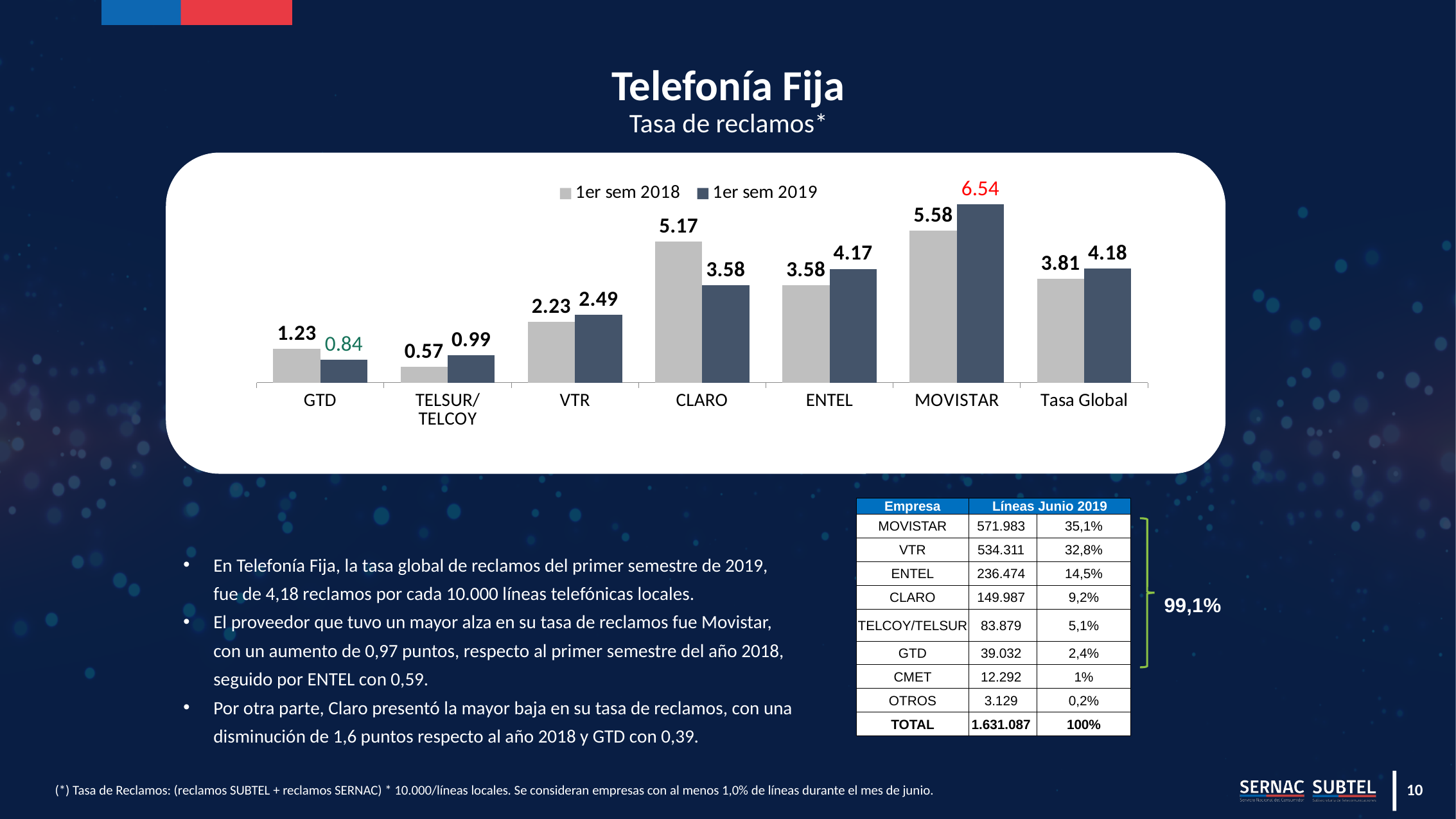
What is the difference between the 1er sem 2019 and 1er sem 2018 values for MOVISTAR? 0.96 Which category has the highest value in the 1er sem 2019 series? MOVISTAR What kind of chart is shown on the slide? Bar chart Which is larger for ENTEL: the 1er sem 2018 value or the 1er sem 2019 value? 1er sem 2019 What is the value for MOVISTAR in the 1er sem 2019 series? 6.54 What are the two series named in the chart legend? 1er sem 2018 and 1er sem 2019 What is the value for GTD in the 1er sem 2019 series? 0.84 How many categories are shown on the x axis of the chart? 7 How many series does the chart legend list? 2 What is the difference between the 1er sem 2018 and 1er sem 2019 values for CLARO? 1.59 Which category has the lowest value in the 1er sem 2018 series? TELSUR/TELCOY What is the value for CLARO in the 1er sem 2018 series? 5.17